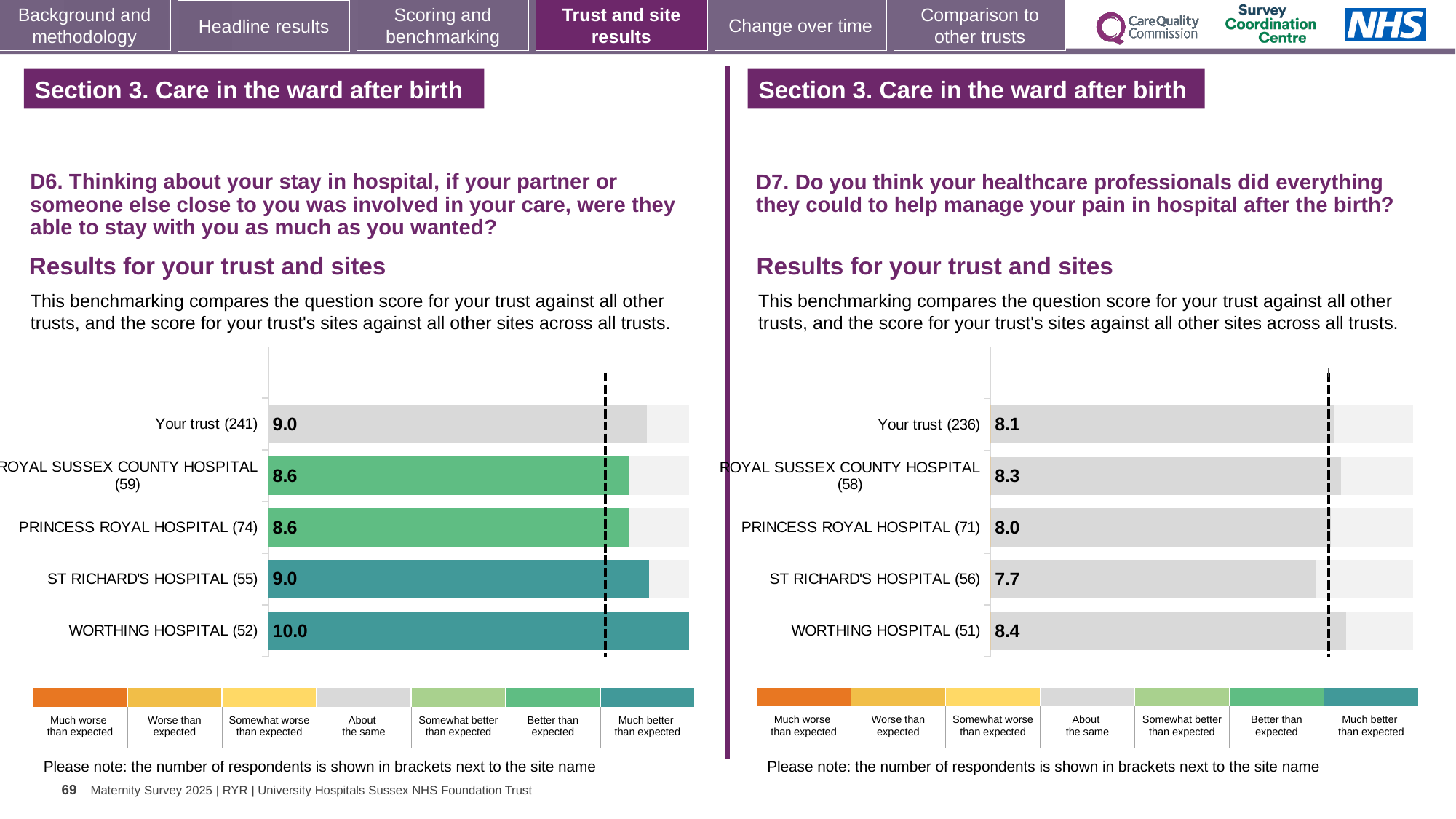
In the D7 chart on the right, what is the score for St Richard's Hospital? 7.7 In the D6 chart on the left, what is the score for Your trust? 9.0 In the D6 chart on the left, which site has the highest score? Worthing Hospital In the D7 chart on the right, which site has the lowest score? St Richard's Hospital In the D7 chart on the right, what is the score for Royal Sussex County Hospital? 8.3 In the D6 chart on the left, what is the score for Worthing Hospital? 10.0 In the D6 chart on the left, what is the difference between the scores for Worthing Hospital and Princess Royal Hospital? 1.4 What type of chart is used on the left for question D6? Bar chart In the D7 chart on the right, which site has the highest score? Worthing Hospital In the D6 chart on the left, how many bars are plotted? 5 In the D7 chart on the right, which is larger: the score for Your trust or the score for Princess Royal Hospital? Your trust In the D7 chart on the right, what is the difference between the scores for Worthing Hospital and St Richard's Hospital? 0.7